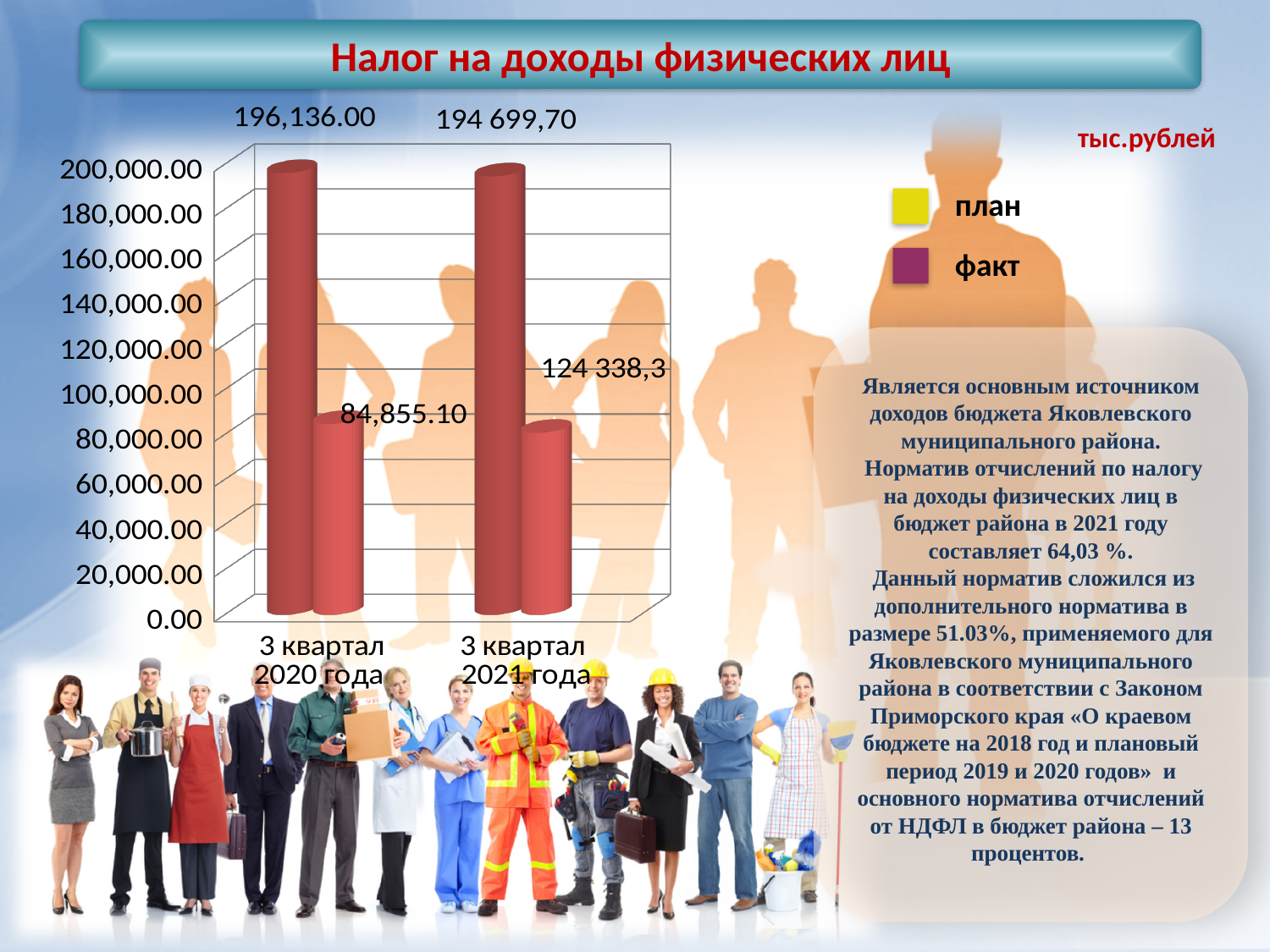
What is the title of the chart? Налог на доходы физических лиц What is the факт value for 3 квартал 2020 года? 84,855.10 What type of chart is shown on the slide? bar chart In what units are the chart values given? тыс.рублей What is the план value for 3 квартал 2021 года? 194 699,70 What is the факт value for 3 квартал 2021 года? 124 338,3 What is the план value for 3 квартал 2020 года? 196,136.00 How many series does the legend list? 2 How many categories are shown on the x axis of the chart? 2 What is the difference between the план and факт values for 3 квартал 2020 года? 111,280.90